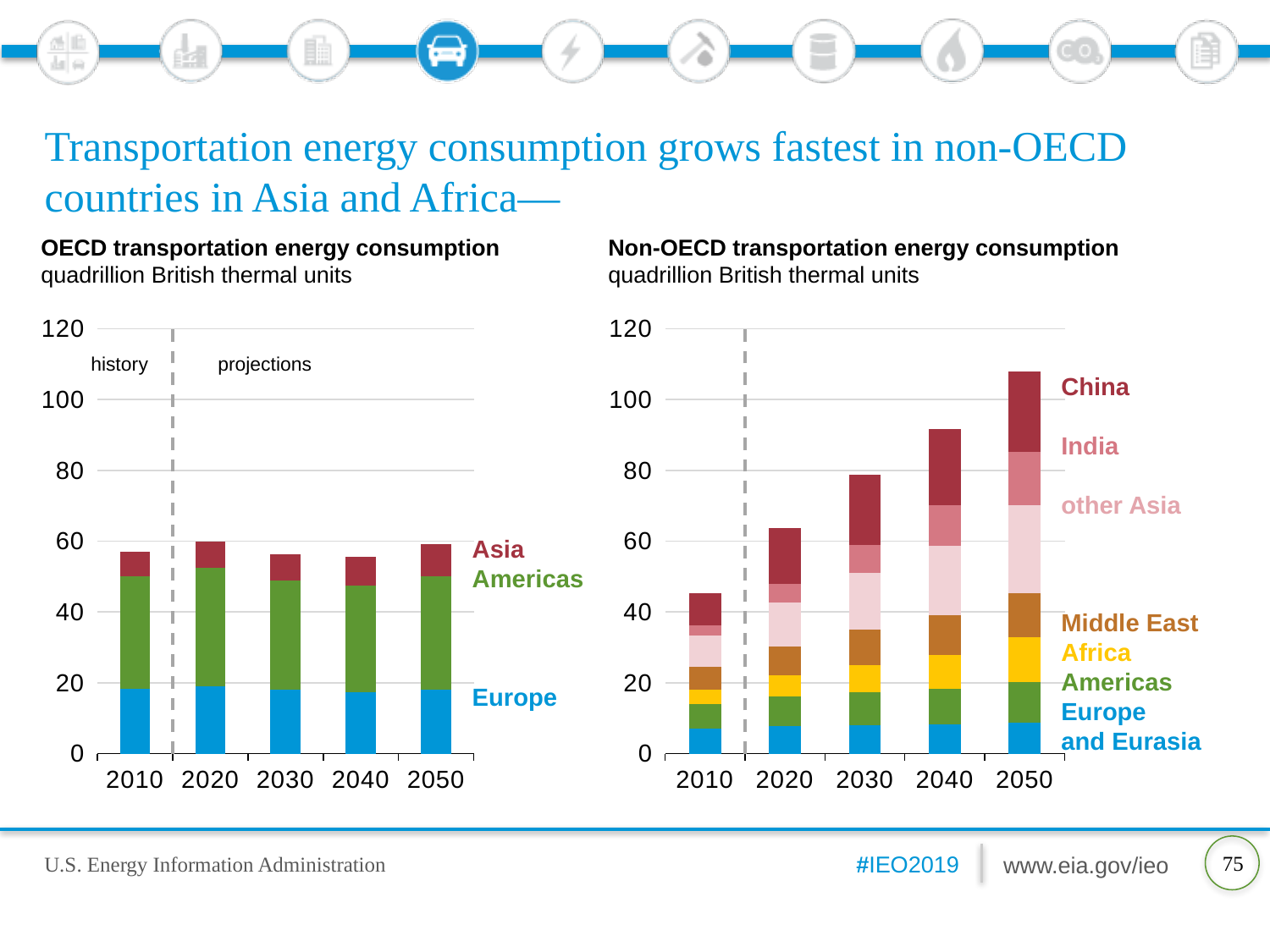
How many regions are listed in the legend of the OECD transportation energy consumption chart? 3 On the Non-OECD transportation energy consumption chart, is the total for 2010 greater or less than 60? less How many years (bars) are shown on the Non-OECD transportation energy consumption chart? 5 On the OECD transportation energy consumption chart, is the total for 2010 greater or less than 80? less What unit is used on both charts? quadrillion British thermal units On the Non-OECD transportation energy consumption chart, do total values rise or fall from 2010 to 2050? rise On the Non-OECD transportation energy consumption chart, is the total for 2050 greater or less than 100? greater How many regions are listed in the legend of the Non-OECD transportation energy consumption chart? 7 Which is larger in 2050: the total on the OECD chart or the total on the Non-OECD chart? Non-OECD What kind of chart is the OECD transportation energy consumption chart? stacked bar chart On the Non-OECD transportation energy consumption chart, which year has the highest total consumption? 2050 On the Non-OECD transportation energy consumption chart, which year has the lowest total consumption? 2010